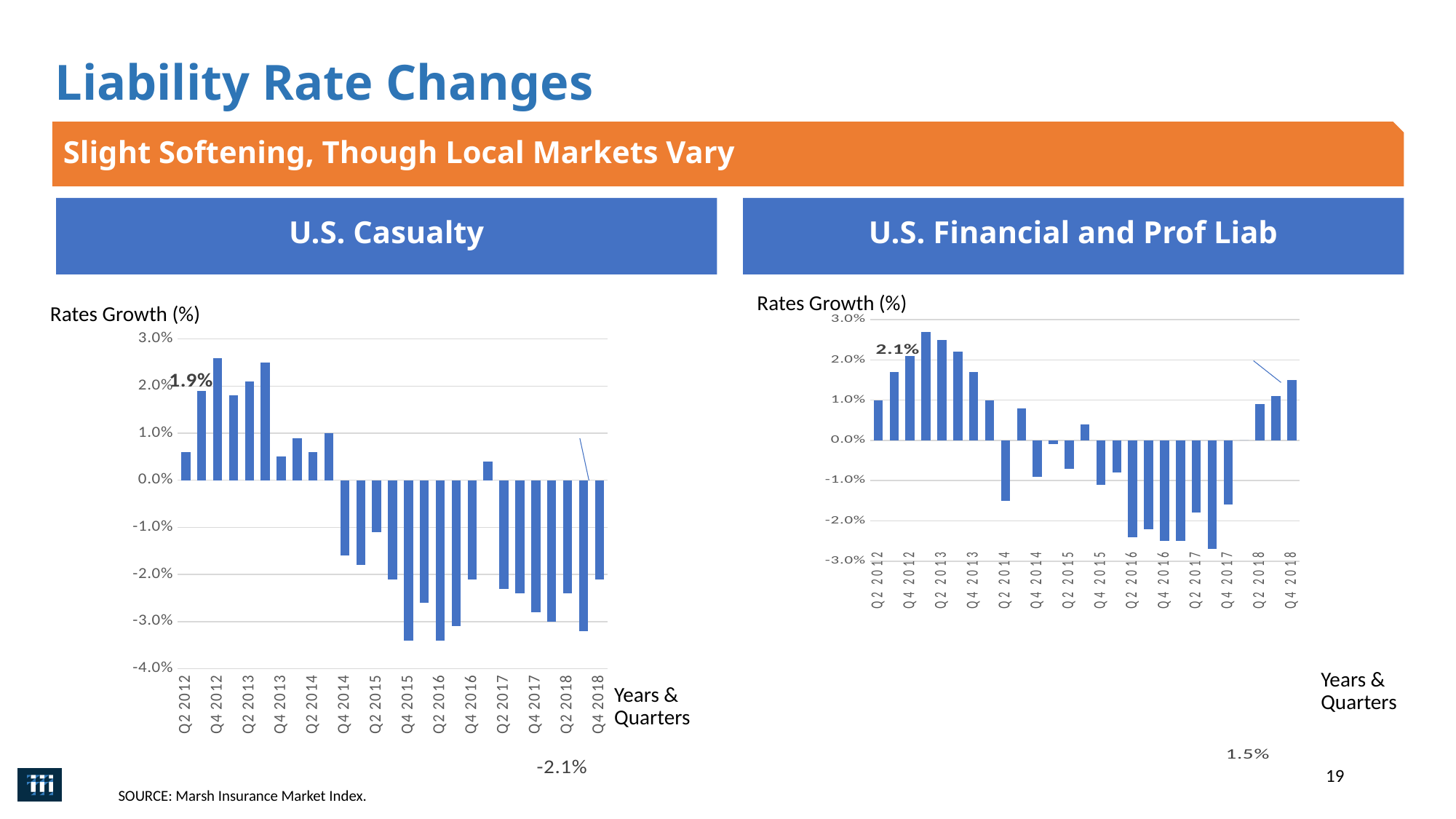
In the U.S. Financial and Prof Liab chart, which is larger, the value for Q4 2017 or the value for Q2 2018? Q2 2018 In the U.S. Casualty chart, which is larger, the value for Q4 2012 or the value for Q2 2014? Q4 2012 In the U.S. Casualty chart, what is the rates growth value for Q4 2018? -2.1% In the U.S. Financial and Prof Liab chart, is the value for Q2 2013 greater or less than 2.0%? greater How many quarter labels are shown on the x axis of the U.S. Casualty chart? 14 In the U.S. Financial and Prof Liab chart, do the values rise or fall from Q2 2013 to Q2 2014? fall In the U.S. Casualty chart, is the value for Q4 2015 greater or less than -3.0%? less In the U.S. Casualty chart, is the value for Q4 2012 greater or less than 2.0%? greater What is the y-axis title of the U.S. Casualty chart? Rates Growth (%) In the U.S. Financial and Prof Liab chart, what is the rates growth value for Q4 2018? 1.5% What kind of chart is used for U.S. Casualty? Bar chart